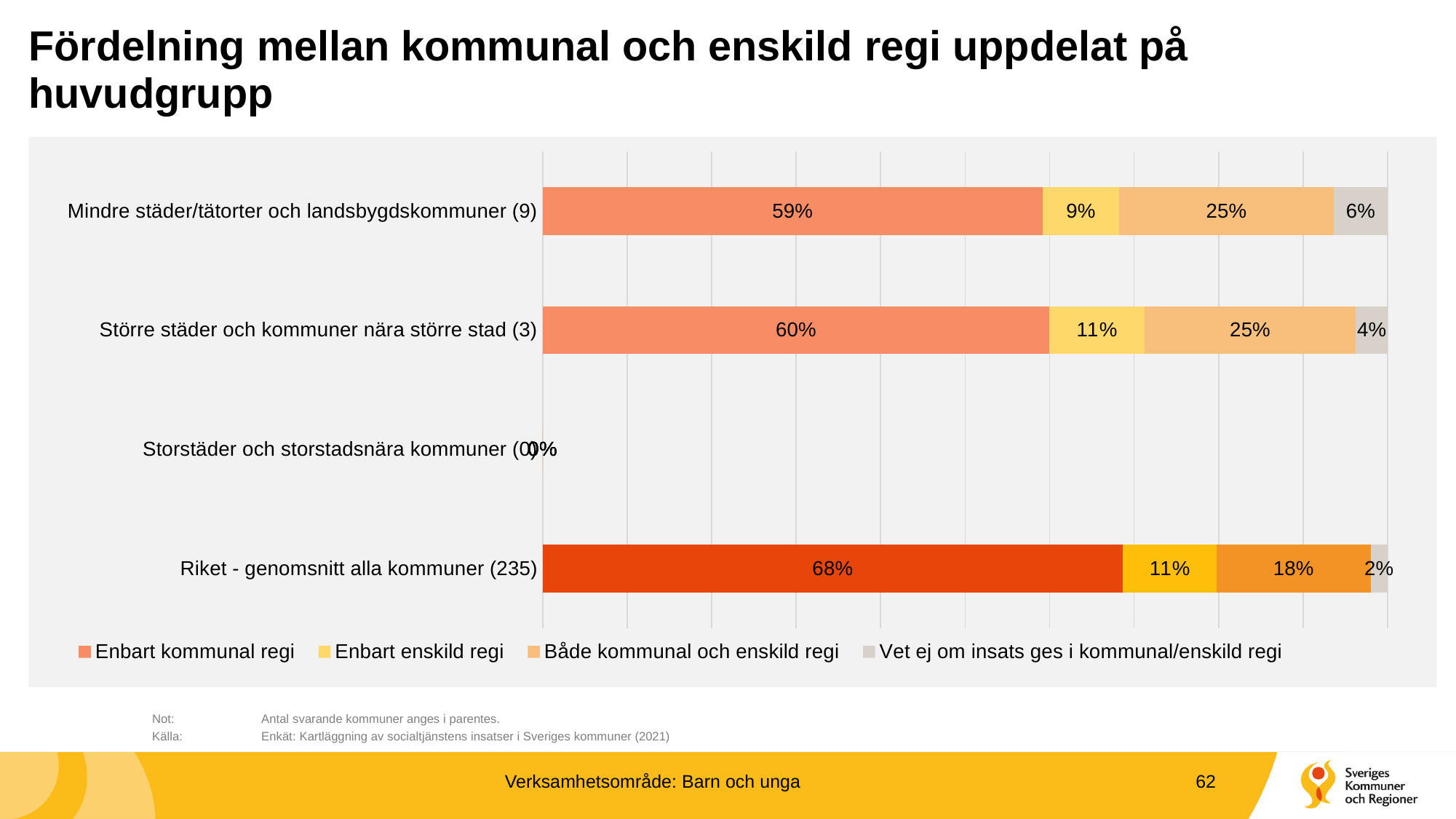
What is the value shown for Storstäder och storstadsnära kommuner (0)? 0% What kind of chart is shown on the slide? Stacked bar chart Which is larger: the "Både kommunal och enskild regi" value for Större städer och kommuner nära större stad (3) or for Riket - genomsnitt alla kommuner (235)? Större städer och kommuner nära större stad (3) Which category has the highest value for "Enbart kommunal regi"? Riket - genomsnitt alla kommuner (235) What is the value for "Enbart enskild regi" for Större städer och kommuner nära större stad (3)? 11% How many categories are shown on the y axis of the chart? 4 Which category has the lowest value for "Vet ej om insats ges i kommunal/enskild regi" among the categories with plotted bars? Riket - genomsnitt alla kommuner (235) What is the value for "Både kommunal och enskild regi" for Mindre städer/tätorter och landsbygdskommuner (9)? 25% How many series does the legend list? 4 What is the difference between the "Enbart kommunal regi" value for Riket - genomsnitt alla kommuner (235) and for Mindre städer/tätorter och landsbygdskommuner (9)? 9 percentage points What is the value for "Vet ej om insats ges i kommunal/enskild regi" for Riket - genomsnitt alla kommuner (235)? 2% What is the value for "Enbart kommunal regi" for Riket - genomsnitt alla kommuner (235)? 68%